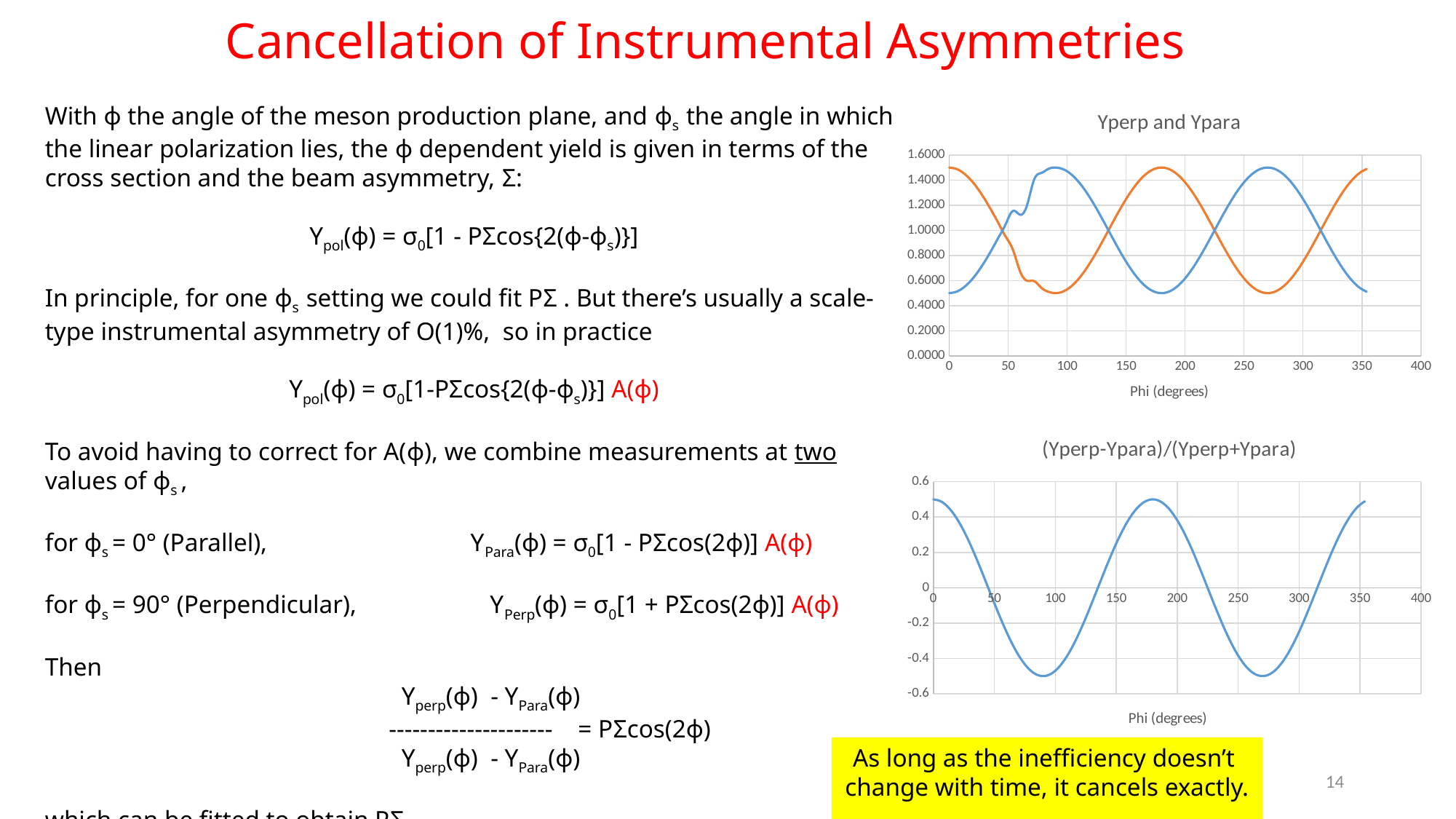
What kind of chart is the bottom chart titled "(Yperp-Ypara)/(Yperp+Ypara)"? line chart How many lines are plotted in the top chart "Yperp and Ypara"? 2 What is the title of the bottom chart on the slide? (Yperp-Ypara)/(Yperp+Ypara) In the top chart "Yperp and Ypara", which line is higher at Phi = 100, the blue line or the orange line? blue line What kind of chart is the top chart titled "Yperp and Ypara"? line chart In the top chart "Yperp and Ypara", is the value of the blue line at Phi = 0 greater or less than 1.0000? less How many lines are plotted in the bottom chart "(Yperp-Ypara)/(Yperp+Ypara)"? 1 In the bottom chart "(Yperp-Ypara)/(Yperp+Ypara)", is the value at Phi = 100 greater or less than -0.4? less In the top chart "Yperp and Ypara", is the value of the orange line at Phi = 0 greater or less than 1.0000? greater In the bottom chart "(Yperp-Ypara)/(Yperp+Ypara)", does the line rise or fall as Phi goes from 0 to 100? fall What is the x-axis title of the top chart "Yperp and Ypara"? Phi (degrees)